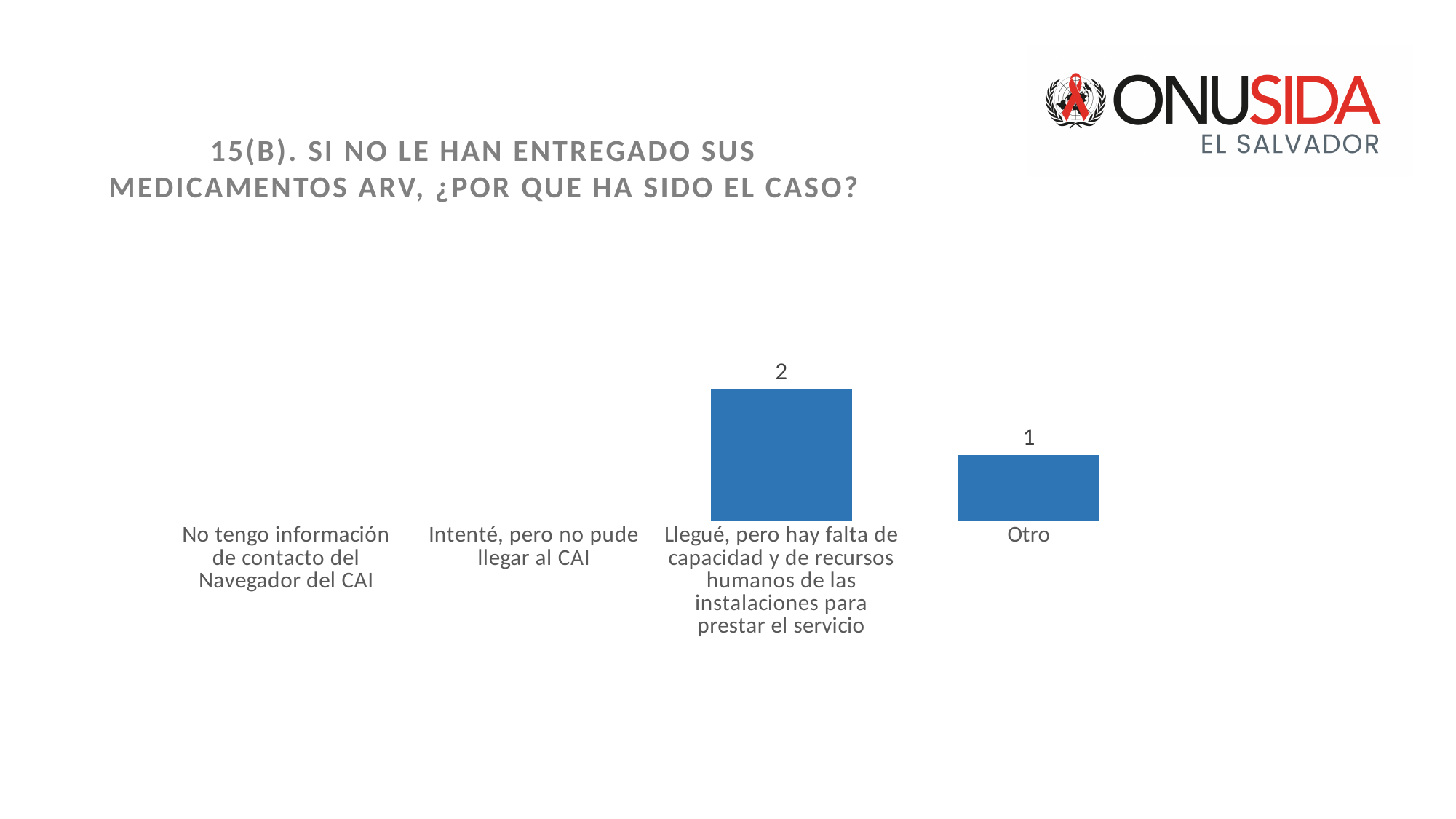
What kind of chart is shown on the slide? Bar chart Which category has the highest value? Llegué, pero hay falta de capacidad y de recursos humanos de las instalaciones para prestar el servicio What is the value for "Otro"? 1 What is the difference between the value for "Llegué, pero hay falta de capacidad y de recursos humanos de las instalaciones para prestar el servicio" and the value for "Otro"? 1 How many categories are shown on the x axis of the chart? 4 How many categories have a visible bar in the chart? 2 What is the title of the chart? 15(B). SI NO LE HAN ENTREGADO SUS MEDICAMENTOS ARV, ¿POR QUE HA SIDO EL CASO? What colour are the bars in the chart? Blue Which is larger, the value for "Otro" or the value for "Llegué, pero hay falta de capacidad y de recursos humanos de las instalaciones para prestar el servicio"? Llegué, pero hay falta de capacidad y de recursos humanos de las instalaciones para prestar el servicio What is the value for "Llegué, pero hay falta de capacidad y de recursos humanos de las instalaciones para prestar el servicio"? 2 What is the total of the values shown as data labels in the chart? 3